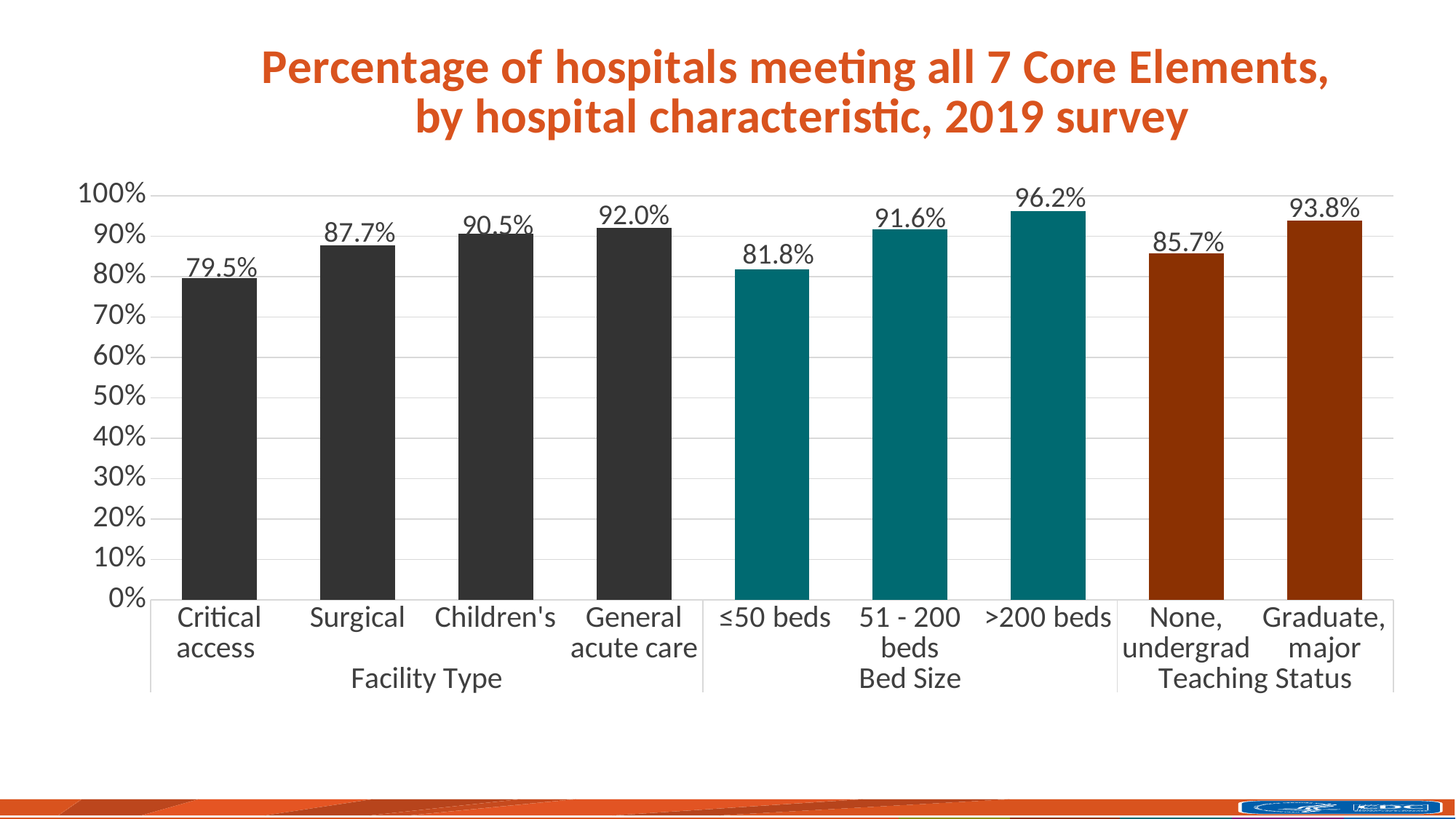
Do the values rise or fall from ≤50 beds to >200 beds? Rise What percentage is shown for the 'Graduate, major' teaching status category? 93.8% Which is larger: the value for Surgical hospitals or the value for Children's hospitals? Children's What is the value shown for hospitals with >200 beds? 96.2% How many bars are plotted on the chart? 9 Is the value for 'None, undergrad' teaching status greater or less than 90%? less What percentage of Critical access hospitals met all 7 Core Elements? 79.5% What are the three group labels shown beneath the x axis? Facility Type, Bed Size, Teaching Status Which category has the lowest percentage of hospitals meeting all 7 Core Elements? Critical access What kind of chart is shown on the slide? Bar chart Which category has the highest percentage of hospitals meeting all 7 Core Elements? >200 beds What is the difference between the percentages for >200 beds and ≤50 beds? 14.4%